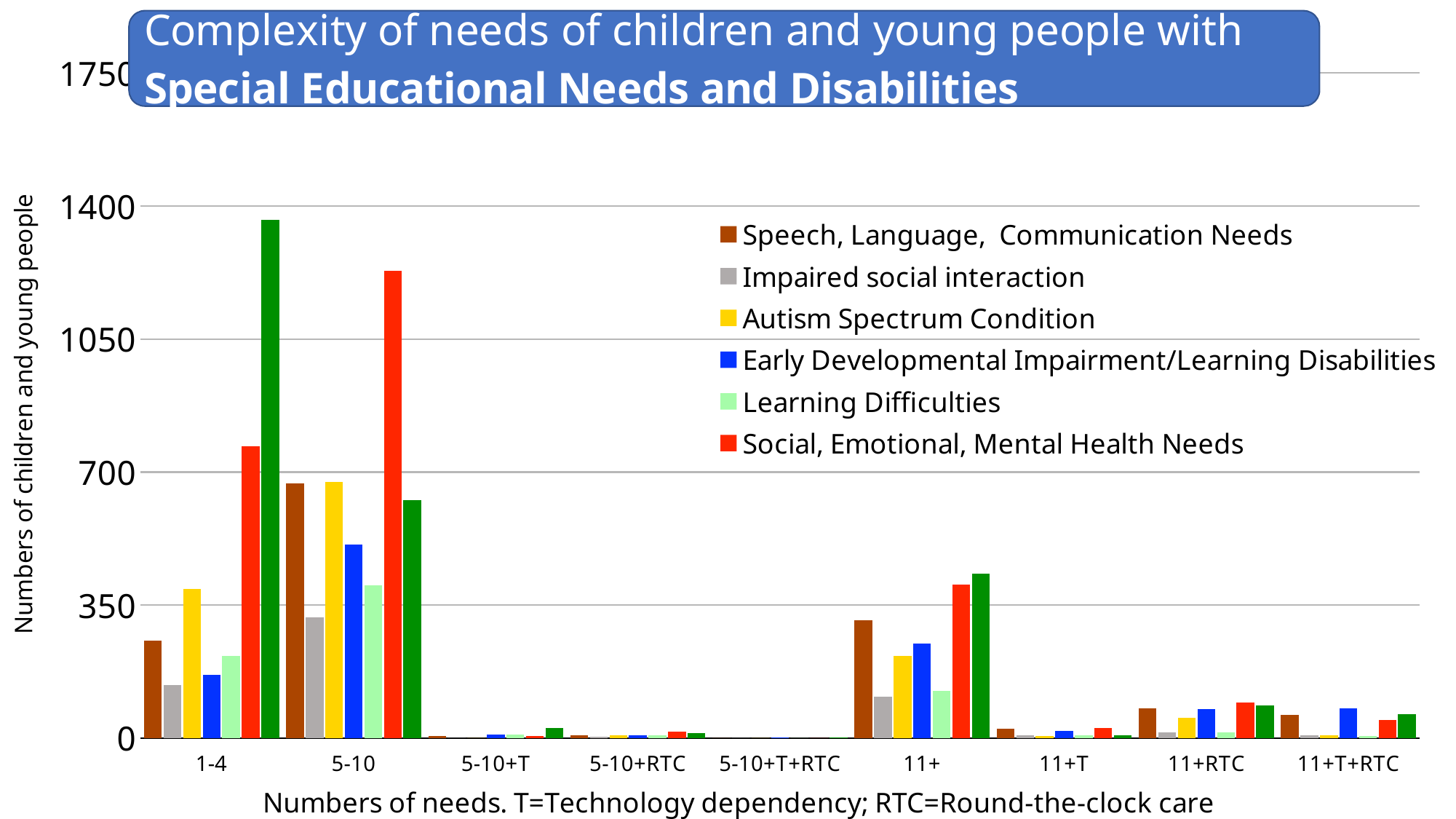
In the 1-4 category, which is larger: Autism Spectrum Condition or Early Developmental Impairment/Learning Disabilities? Autism Spectrum Condition Is the value for Speech, Language, Communication Needs in the 11+ category greater or less than 350? less How many series does the legend list? 6 What is the x-axis label of the chart? Numbers of needs. T=Technology dependency; RTC=Round-the-clock care Which is larger for Social, Emotional, Mental Health Needs: the 1-4 category or the 5-10 category? 5-10 What kind of chart is shown on the slide? bar chart Is the value for Social, Emotional, Mental Health Needs in the 1-4 category greater or less than 700? greater How many categories are shown along the x axis? 9 In which category does Speech, Language, Communication Needs reach its highest value? 5-10 Is the value for Early Developmental Impairment/Learning Disabilities in the 5-10 category greater or less than 350? greater Among the series listed in the legend, which has the highest value in the 5-10 category? Social, Emotional, Mental Health Needs